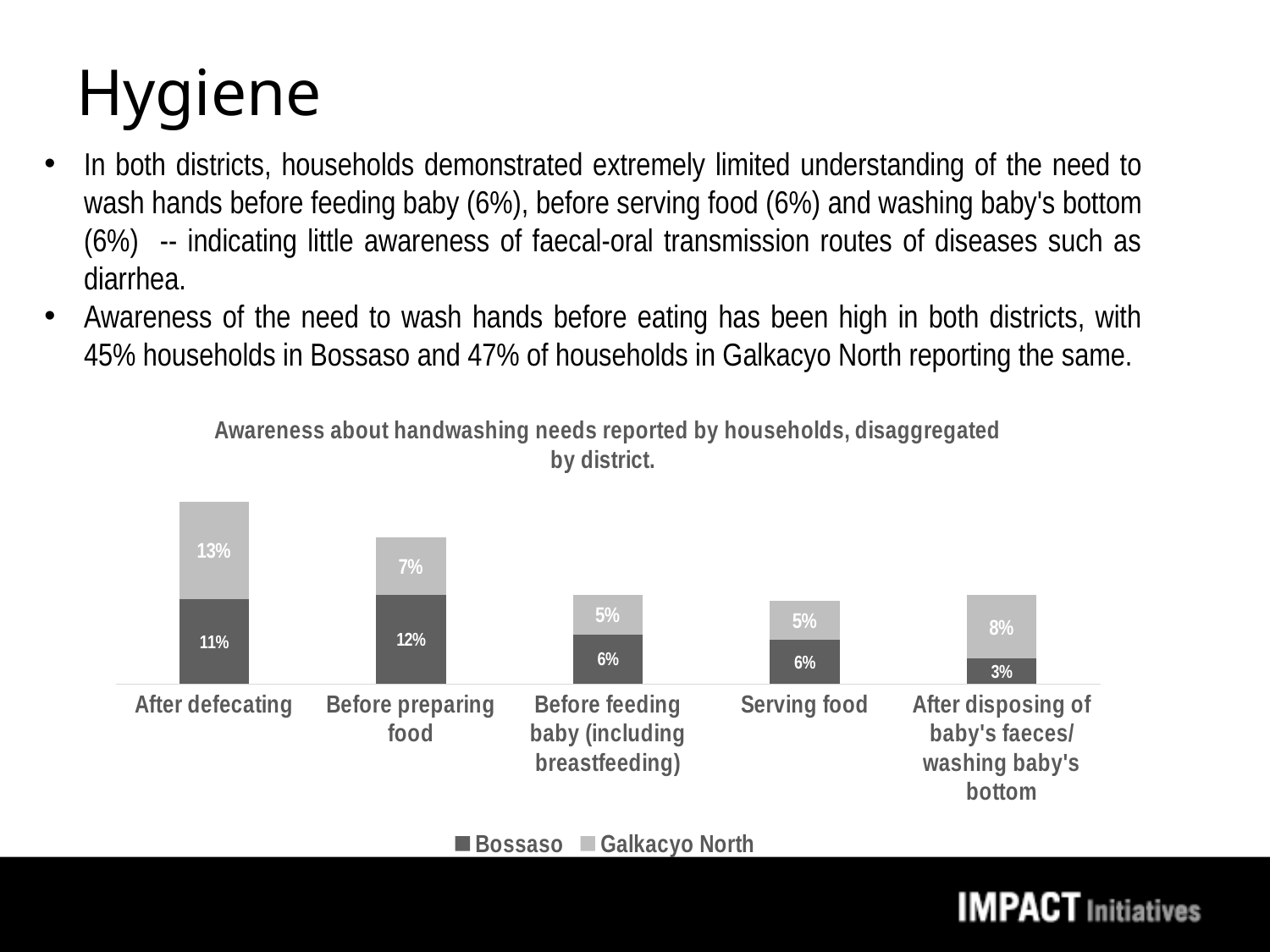
What is the Galkacyo North value for 'Before preparing food'? 7% Which category has the highest Bossaso value? Before preparing food What kind of chart is shown on the slide? Stacked bar chart How many series does the legend list? 2 Which category has the lowest Bossaso value? After disposing of baby's faeces/ washing baby's bottom What is the Bossaso value for 'After defecating'? 11% Which category has the highest Galkacyo North value? After defecating Which is larger for 'Before preparing food': the Bossaso value or the Galkacyo North value? Bossaso What is the difference between the Galkacyo North and Bossaso values for 'After disposing of baby's faeces/ washing baby's bottom'? 5% What is the total of the stacked bar for 'After defecating'? 24% What is the Bossaso value for 'After disposing of baby's faeces/ washing baby's bottom'? 3% What is the Galkacyo North value for 'Serving food'? 5%